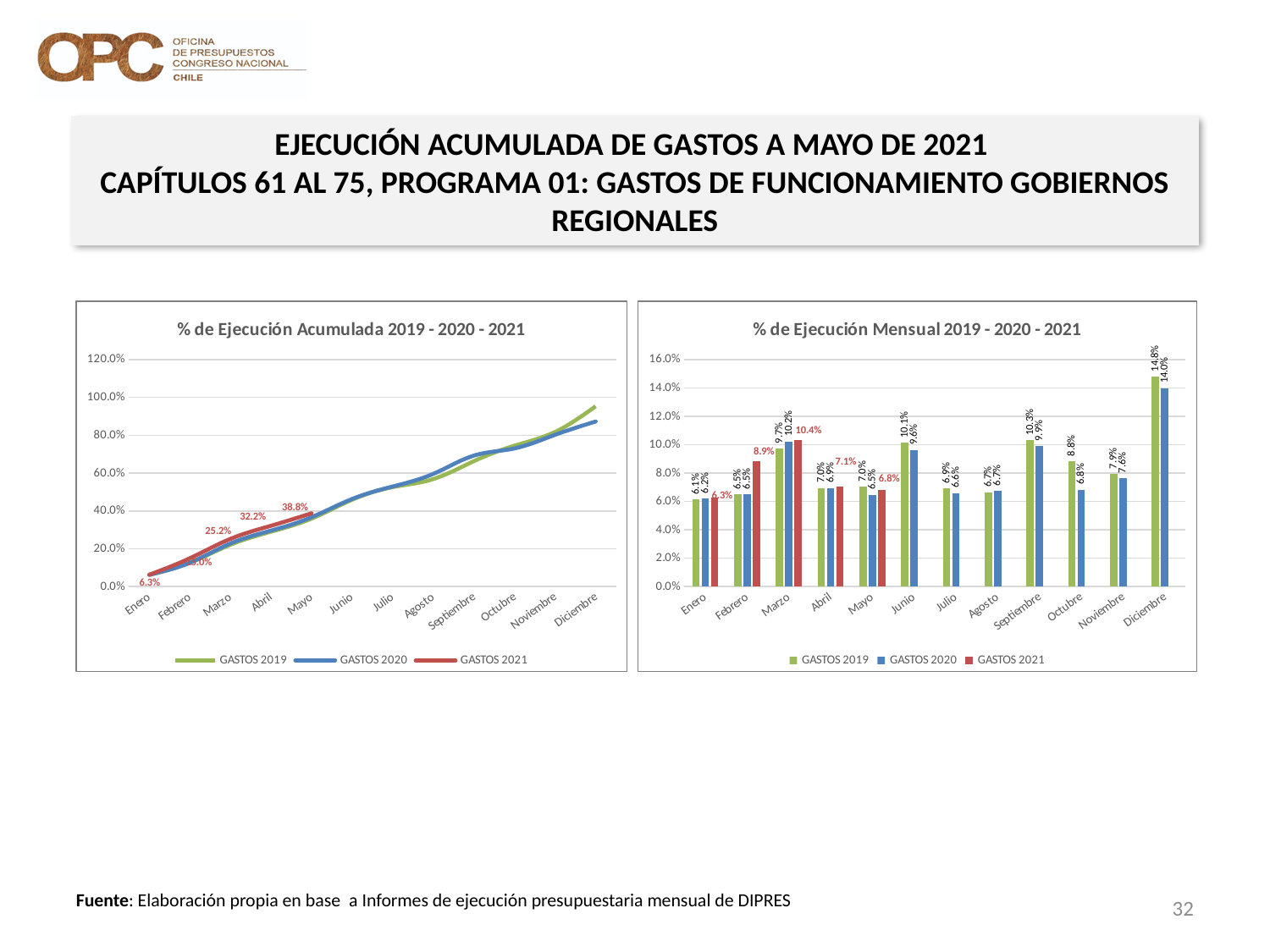
How many months are shown on the x axis of the right chart '% de Ejecución Mensual'? 12 In the left chart '% de Ejecución Acumulada', what is the GASTOS 2021 value for Mayo? 38.8% In the right chart '% de Ejecución Mensual', which is larger for Febrero: GASTOS 2019 or GASTOS 2021? GASTOS 2021 What kind of chart is the right chart titled '% de Ejecución Mensual 2019 - 2020 - 2021'? Bar chart How many series does the legend of the right chart '% de Ejecución Mensual' list? 3 In the right chart '% de Ejecución Mensual', which month has the highest GASTOS 2020 value? Diciembre In the right chart '% de Ejecución Mensual', what is the difference between the GASTOS 2019 and GASTOS 2020 values for Octubre? 2.0 percentage points What kind of chart is the left chart titled '% de Ejecución Acumulada 2019 - 2020 - 2021'? Line chart In the left chart '% de Ejecución Acumulada', is the GASTOS 2020 value for Diciembre greater or less than 80.0%? greater In the right chart '% de Ejecución Mensual', what is the GASTOS 2019 value for Diciembre? 14.8% In the right chart '% de Ejecución Mensual', what is the GASTOS 2021 value for Marzo? 10.4% In the left chart '% de Ejecución Acumulada', what is the GASTOS 2021 value for Marzo? 25.2%